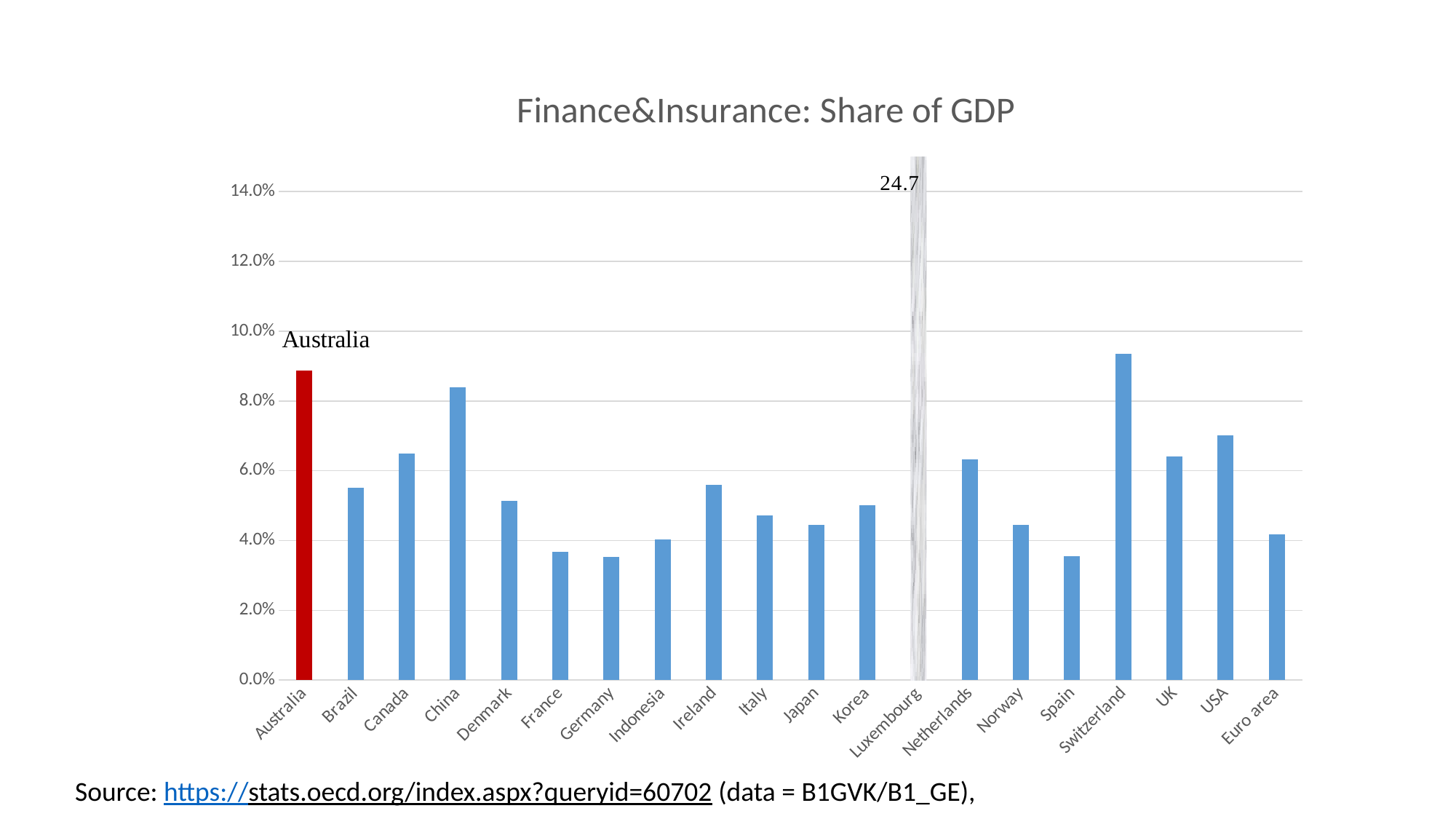
Which has a larger Finance&Insurance share of GDP, Australia or Brazil? Australia Is the value for Germany greater or less than 4.0%? less Is the value for Switzerland greater or less than 8.0%? greater What value is printed for Luxembourg in the chart? 24.7 What kind of chart is shown on the slide? bar chart How many countries or regions are shown on the x axis of the chart? 20 Which country's bar is highlighted in red in the chart? Australia Is the value for USA greater or less than 6.0%? greater Which country has the highest Finance&Insurance share of GDP in the chart? Luxembourg What is the title of the chart? Finance&Insurance: Share of GDP Which has a larger Finance&Insurance share of GDP, Switzerland or USA? Switzerland